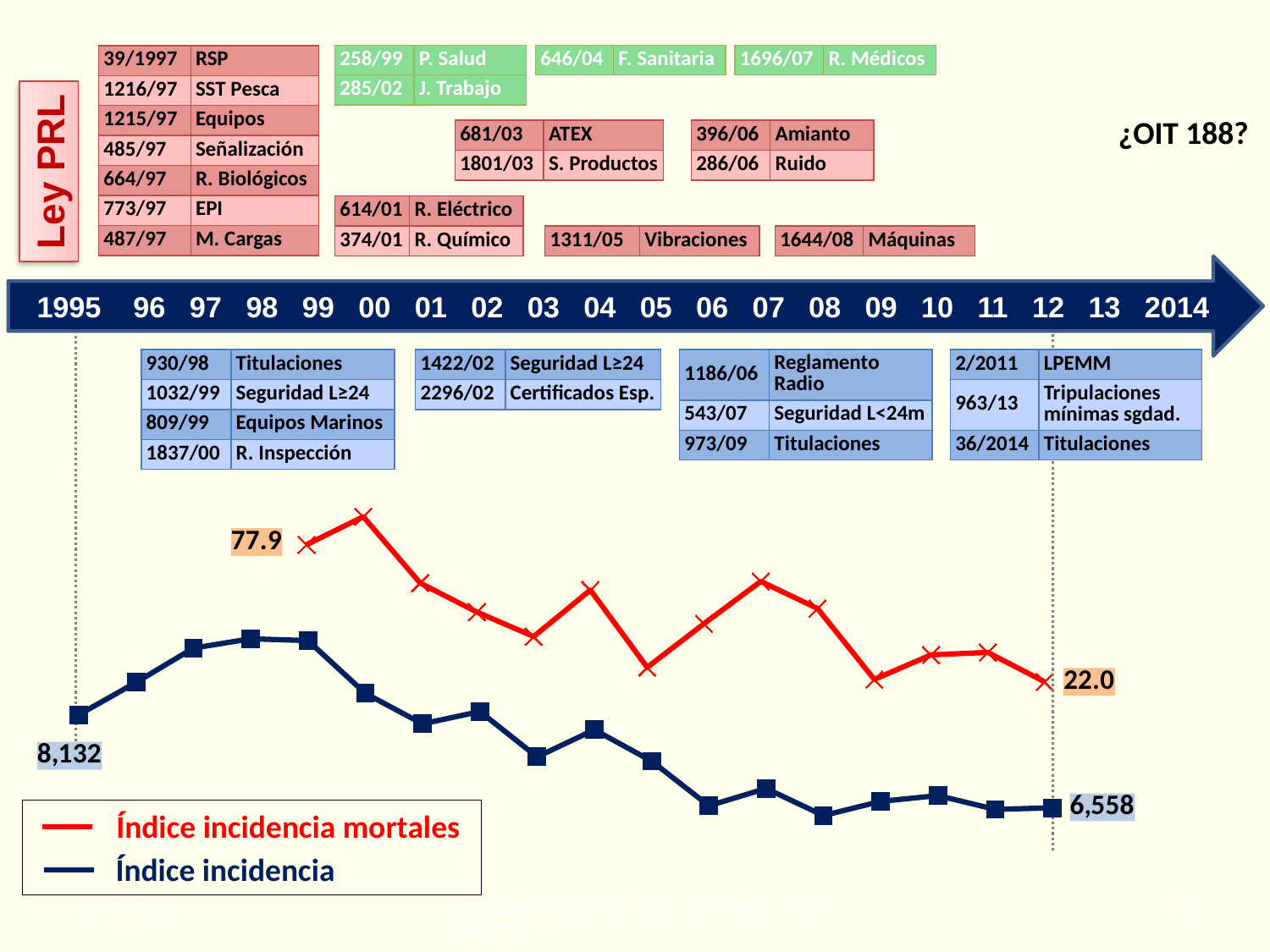
What are the two series named in the chart legend? Índice incidencia mortales and Índice incidencia Overall, does the Índice incidencia mortales line rise or fall from 1999 to 2012? fall What is the value of Índice incidencia mortales at 2012? 22.0 What colour is the line for Índice incidencia mortales? red What kind of chart is shown on the slide? line chart By how much did Índice incidencia fall between 1995 (8,132) and 2012 (6,558)? 1,574 What is the value of Índice incidencia at 2012? 6,558 What is the difference between the 1999 value (77.9) and the 2012 value (22.0) of Índice incidencia mortales? 55.9 What is the first labelled value of the Índice incidencia mortales series, at 1999? 77.9 How many series does the chart legend list? 2 What is the value of Índice incidencia at 1995? 8,132 In which year does the Índice incidencia mortales line reach its highest point? 2000